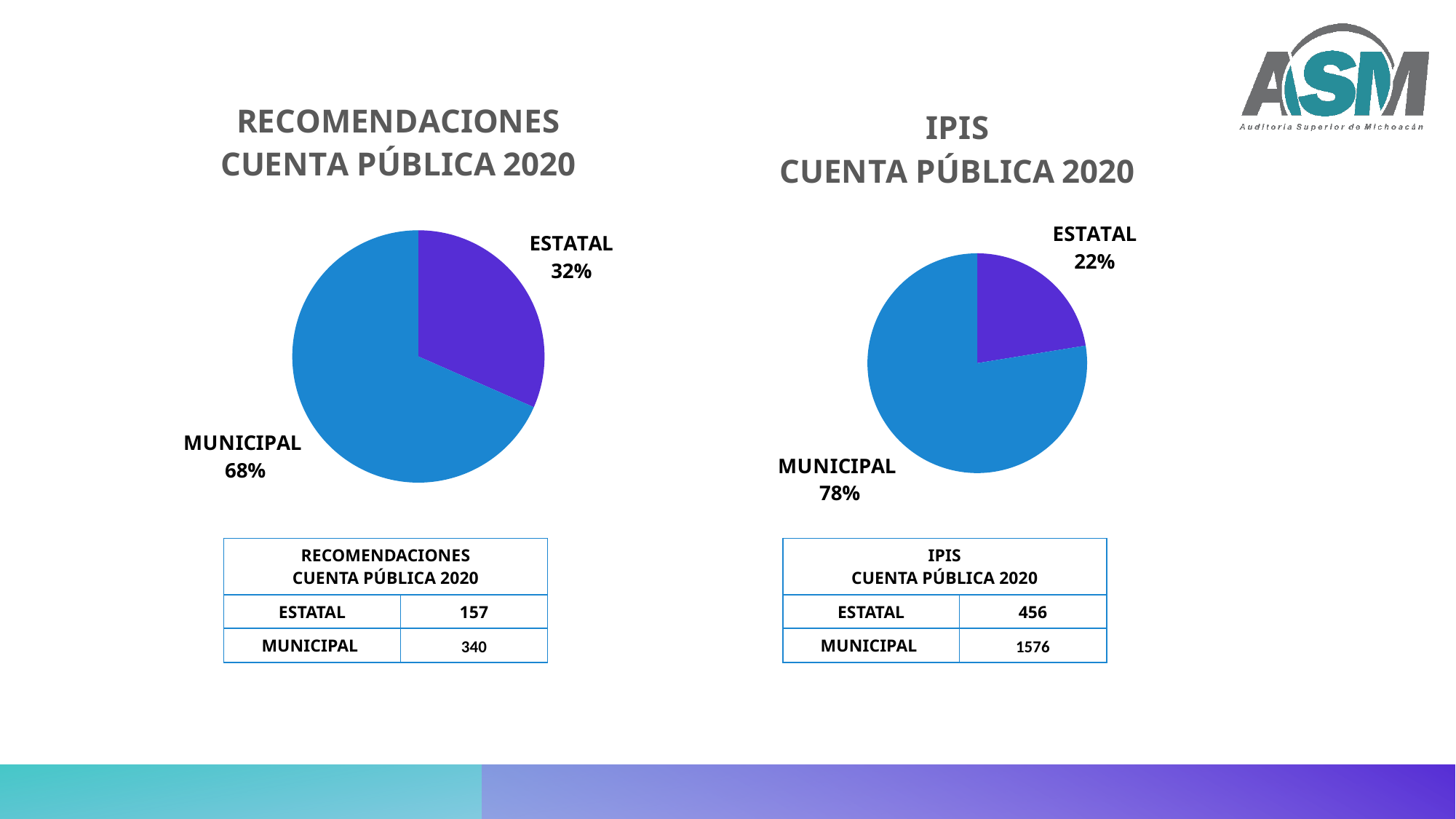
In the IPIS CUENTA PÚBLICA 2020 chart, what is the difference in percentage points between the MUNICIPAL and ESTATAL shares? 56 In the RECOMENDACIONES CUENTA PÚBLICA 2020 chart, what is the difference in percentage points between the MUNICIPAL and ESTATAL shares? 36 In the IPIS CUENTA PÚBLICA 2020 chart, what share of the pie is MUNICIPAL? 78% How many slices does the IPIS CUENTA PÚBLICA 2020 pie chart have? 2 In the IPIS CUENTA PÚBLICA 2020 chart, which category has the smallest slice? ESTATAL In the RECOMENDACIONES CUENTA PÚBLICA 2020 chart, which category has the largest slice? MUNICIPAL In the IPIS CUENTA PÚBLICA 2020 chart, what colour is the MUNICIPAL slice? Blue In the RECOMENDACIONES CUENTA PÚBLICA 2020 chart, what share of the pie is MUNICIPAL? 68% What kind of chart is the RECOMENDACIONES CUENTA PÚBLICA 2020 chart? Pie chart Which chart has the larger ESTATAL share, RECOMENDACIONES CUENTA PÚBLICA 2020 or IPIS CUENTA PÚBLICA 2020? RECOMENDACIONES CUENTA PÚBLICA 2020 In the RECOMENDACIONES CUENTA PÚBLICA 2020 chart, what share of the pie is ESTATAL? 32%